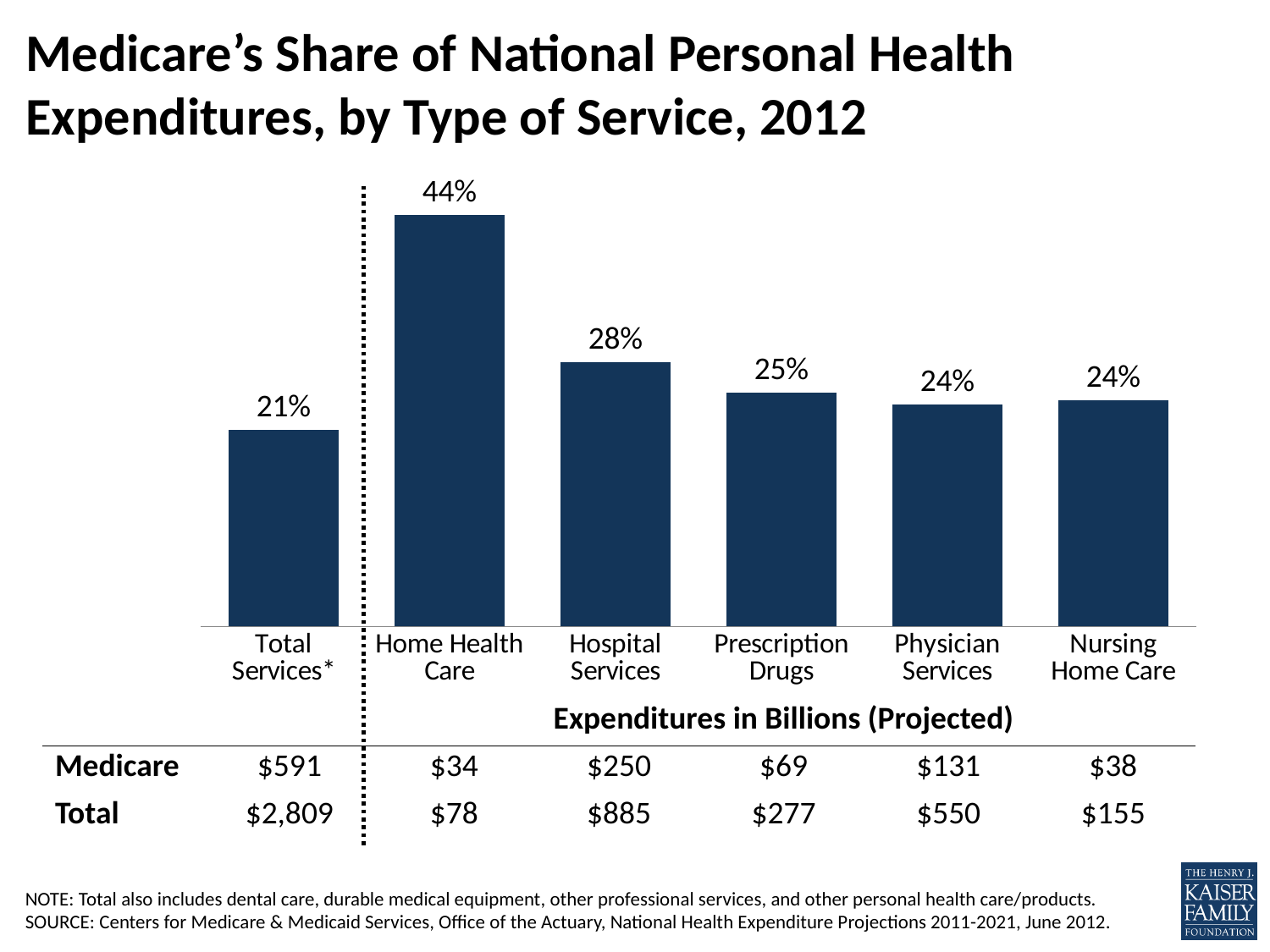
What is the title of the chart? Medicare's Share of National Personal Health Expenditures, by Type of Service, 2012 What is Medicare's share for Total Services? 21% What is the difference in percentage points between the Medicare share for Home Health Care and for Hospital Services? 16 What is Medicare's share for Hospital Services? 28% What are the projected total expenditures in billions for Physician Services? $550 What is Medicare's share of national personal health expenditures for Home Health Care? 44% Which type of service has the highest Medicare share? Home Health Care Which category has the lowest Medicare share? Total Services* What kind of chart is shown on the slide? Bar chart Which has a larger Medicare share, Prescription Drugs or Total Services? Prescription Drugs What are the projected Medicare expenditures in billions for Hospital Services? $250 How many categories are shown in the bar chart? 6